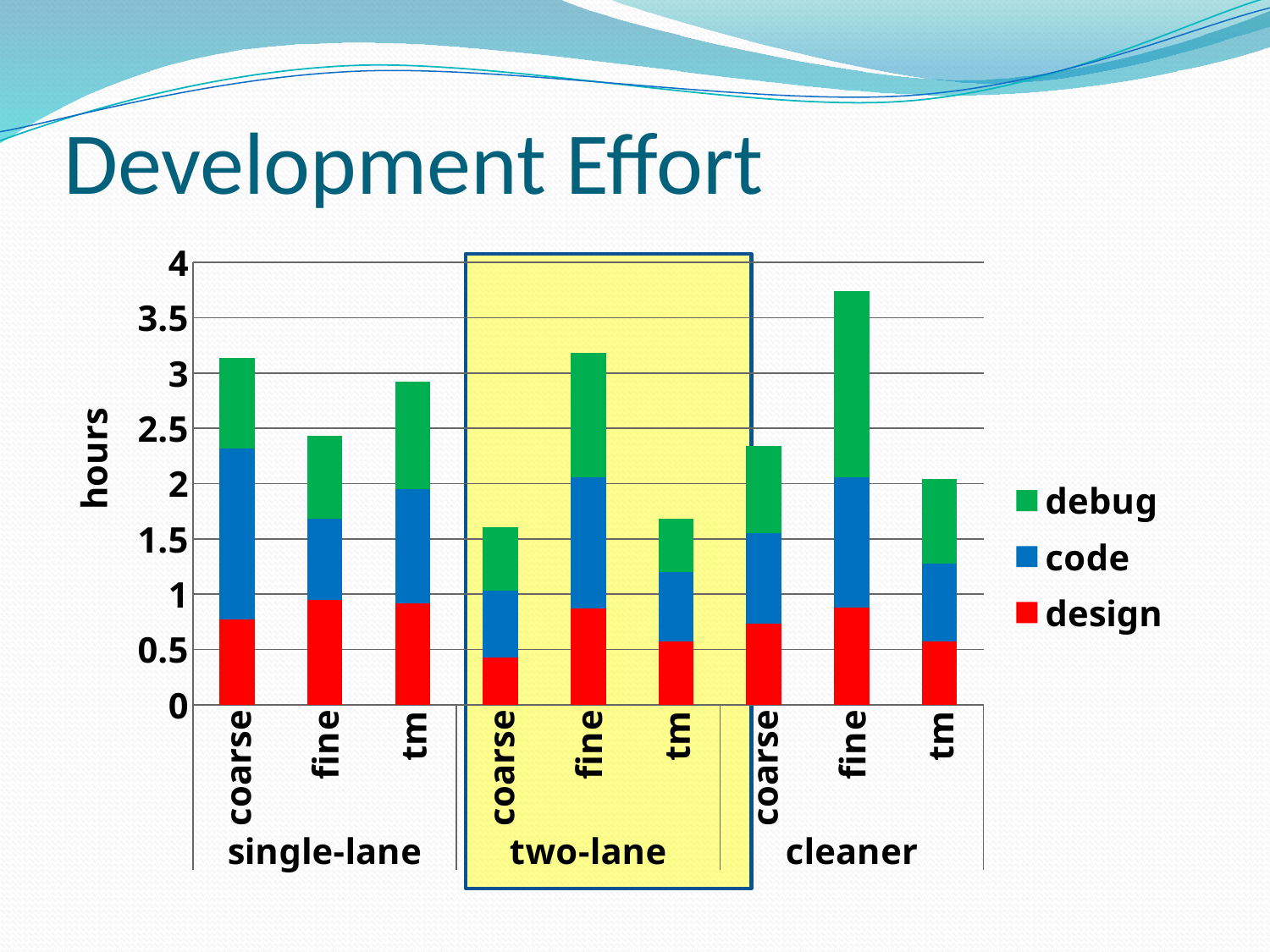
Is the total for cleaner fine greater or less than 3.5 hours? greater Which has a larger total: single-lane coarse or single-lane fine? single-lane coarse Is the total for two-lane coarse greater or less than 2 hours? less Within the cleaner group, which bar has the lowest total hours? tm Is the total for single-lane coarse greater or less than 3 hours? greater What kind of chart is shown on the slide? stacked bar chart How many series does the legend list? 3 Which group of bars is highlighted with a yellow box? two-lane Which bar has the highest total hours? cleaner fine How many bars are plotted in the chart? 9 Within the single-lane group, which bar has the lowest total hours? fine What is the label on the vertical axis? hours